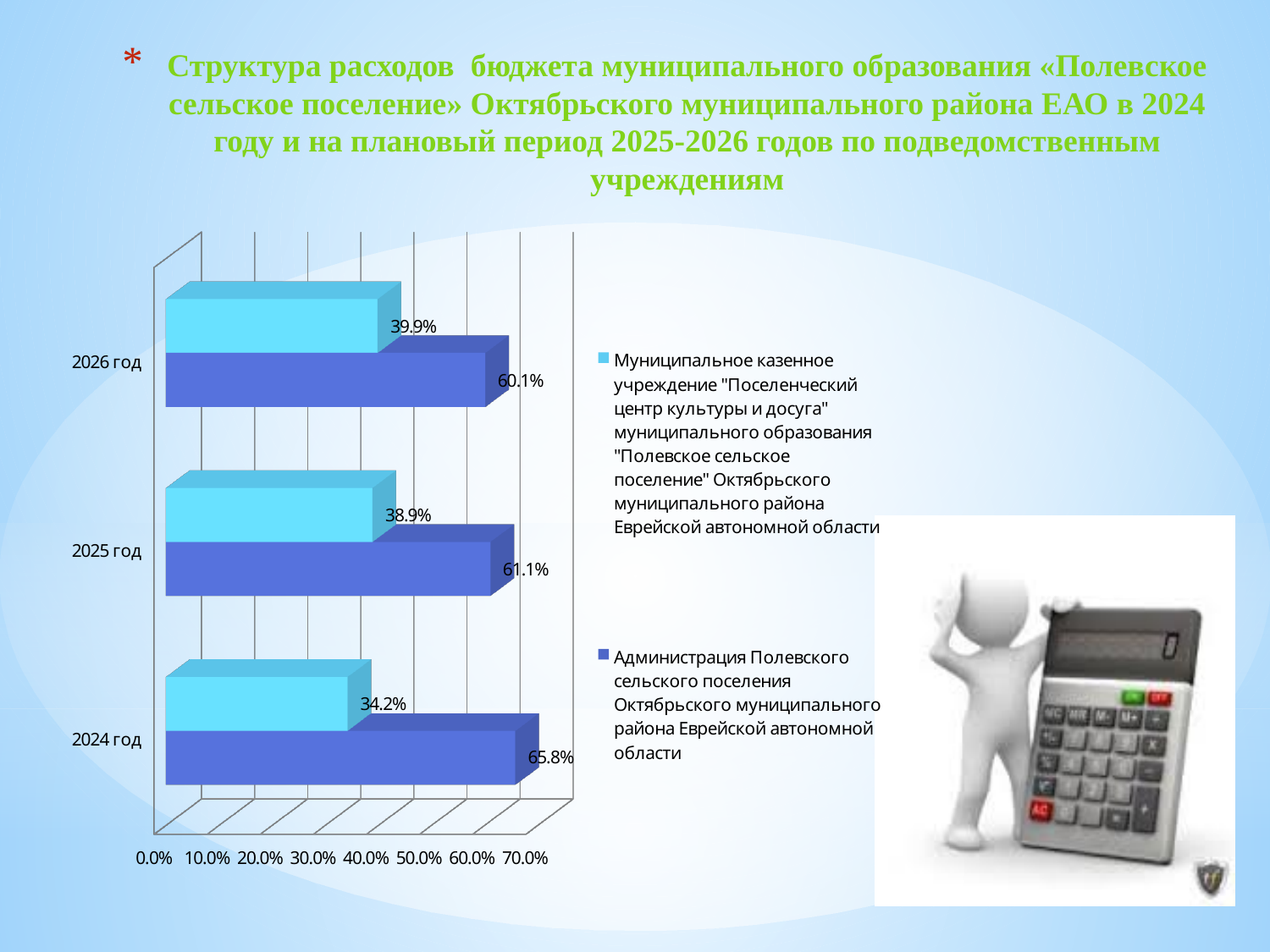
What is the value for Муниципальное казенное учреждение "Поселенческий центр культуры и досуга" in 2026 год? 39.9% What kind of chart is shown on the slide? Bar chart What is the difference between the Администрация value and the Муниципальное казенное учреждение value in 2024 год? 31.6% How many series does the legend list? 2 What is the value for Администрация Полевского сельского поселения in 2024 год? 65.8% How many years (categories) are shown on the chart? 3 Which series has the larger value in 2026 год: Администрация Полевского сельского поселения or Муниципальное казенное учреждение "Поселенческий центр культуры и досуга"? Администрация Полевского сельского поселения What is the value for Администрация Полевского сельского поселения in 2025 год? 61.1% Does the value for Муниципальное казенное учреждение "Поселенческий центр культуры и досуга" rise or fall from 2024 год to 2026 год? Rise In which year is the value for Администрация Полевского сельского поселения the highest? 2024 год What is the value for Муниципальное казенное учреждение "Поселенческий центр культуры и досуга" in 2025 год? 38.9% In which year is the value for Муниципальное казенное учреждение "Поселенческий центр культуры и досуга" the lowest? 2024 год